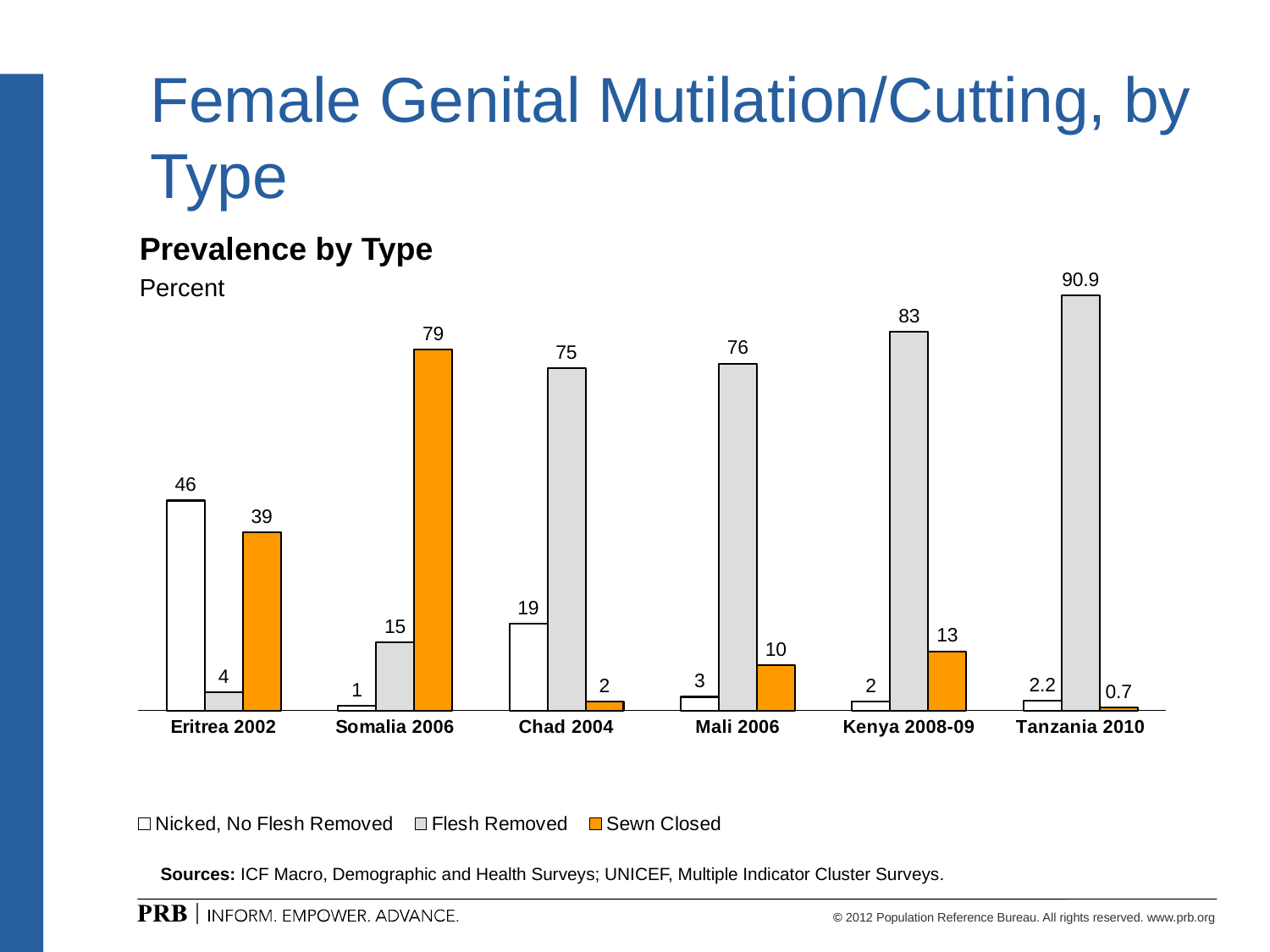
What is the total of the three values for Mali 2006? 89 Which country has the highest value for Flesh Removed? Tanzania 2010 What is the value for Flesh Removed in Tanzania 2010? 90.9 What is the value for Sewn Closed in Somalia 2006? 79 Which series is shown in orange? Sewn Closed What kind of chart is shown on the slide? Bar chart What is the value for Nicked, No Flesh Removed in Eritrea 2002? 46 What is the difference between the Flesh Removed values for Kenya 2008-09 and Chad 2004? 8 How many countries are shown on the x axis? 6 Which is larger, the Sewn Closed value for Eritrea 2002 or the Sewn Closed value for Kenya 2008-09? Eritrea 2002 How many series does the legend list? 3 Which country has the lowest value for Sewn Closed? Tanzania 2010